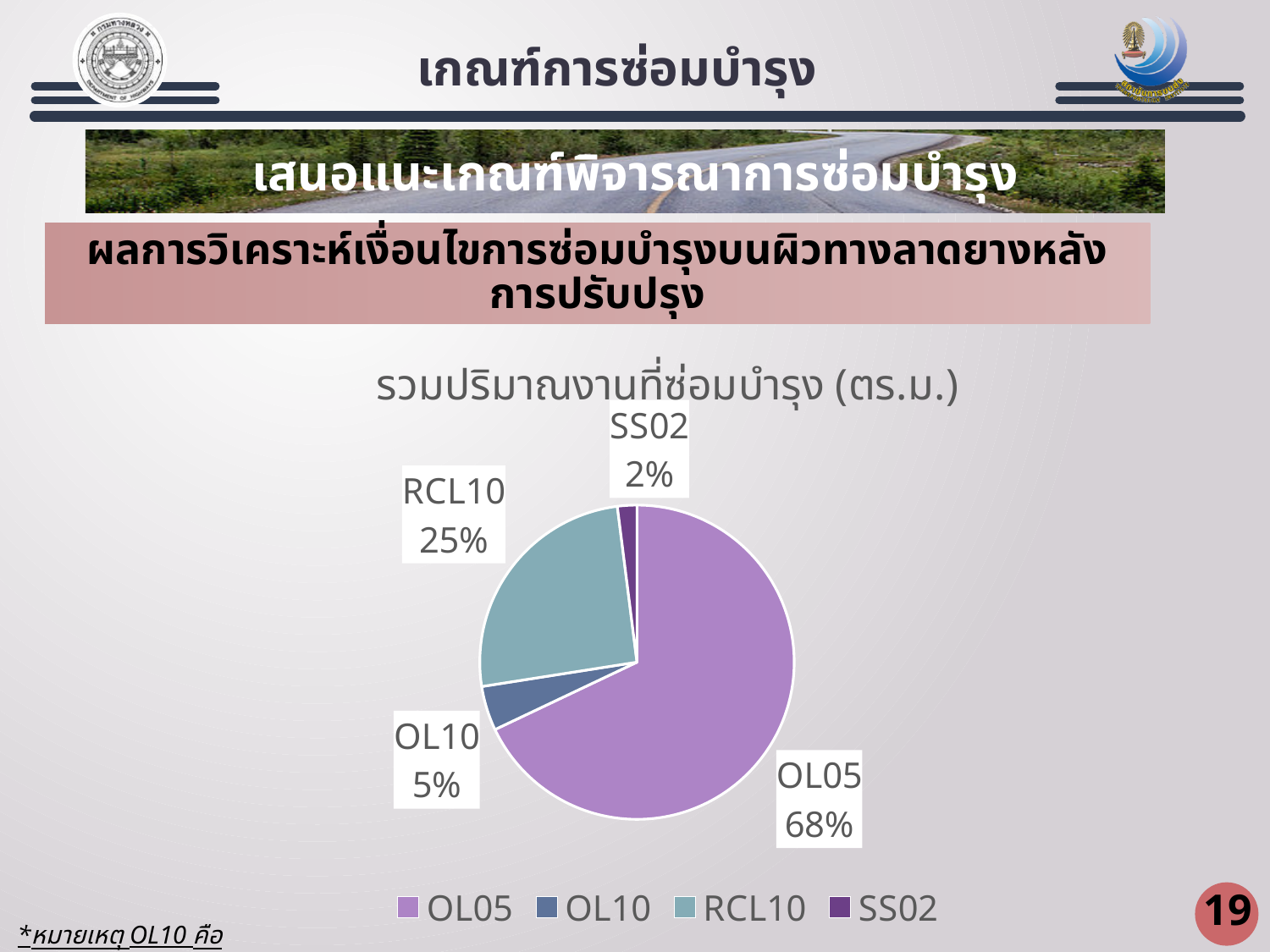
Which category has the largest slice of the pie? OL05 What is the title of the chart? รวมปริมาณงานที่ซ่อมบำรุง (ตร.ม.) How many categories are shown in the pie chart? 4 What type of chart is shown on the slide? Pie chart What is the difference in percentage points between the OL05 and RCL10 slices? 43% How many entries does the legend list? 4 What share of the pie does OL05 represent? 68% What share of the pie does SS02 represent? 2% What share of the pie does OL10 represent? 5% Which slice is larger, RCL10 or OL10? RCL10 Which category has the smallest slice of the pie? SS02